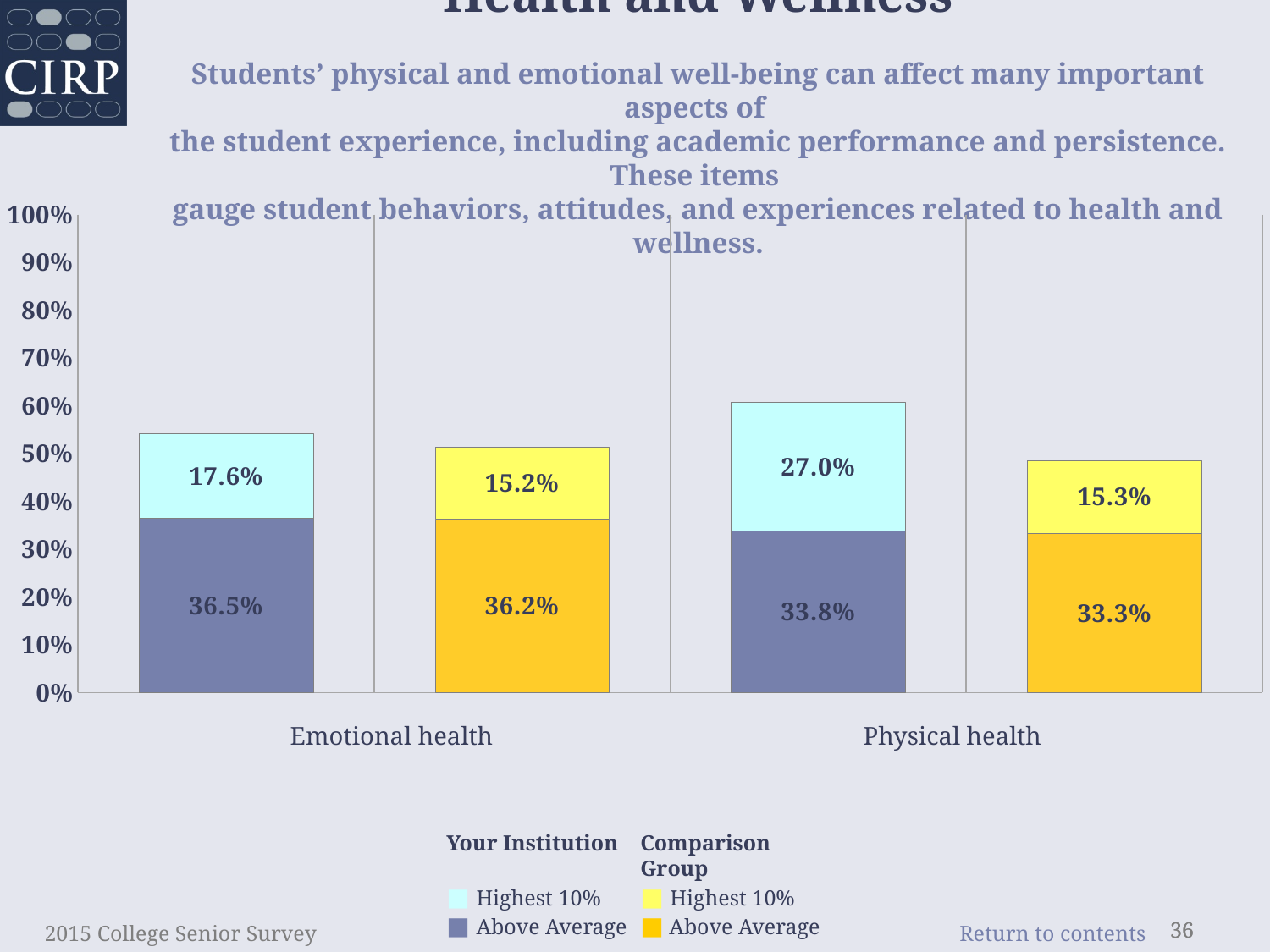
Which stacked bar has the highest total? Your Institution, Physical health What is the total of the stacked bar for Your Institution for Physical health? 60.8% What kind of chart is shown on the slide? Stacked bar chart What is the difference between the Highest 10% values for Your Institution and the Comparison Group for Physical health? 11.7% What is the Above Average value for the Comparison Group for Physical health? 33.3% What is the Highest 10% value for Your Institution for Physical health? 27.0% Is the total of the Comparison Group bar for Physical health greater or less than 50%? less What percentage of Your Institution students rated their emotional health in the Highest 10%? 17.6% What is the total of the stacked bar for the Comparison Group for Emotional health? 51.4% What is the Above Average value for Your Institution for Emotional health? 36.5% How many categories are shown on the x axis? 2 Which is larger for Physical health: the Highest 10% value for Your Institution or for the Comparison Group? Your Institution